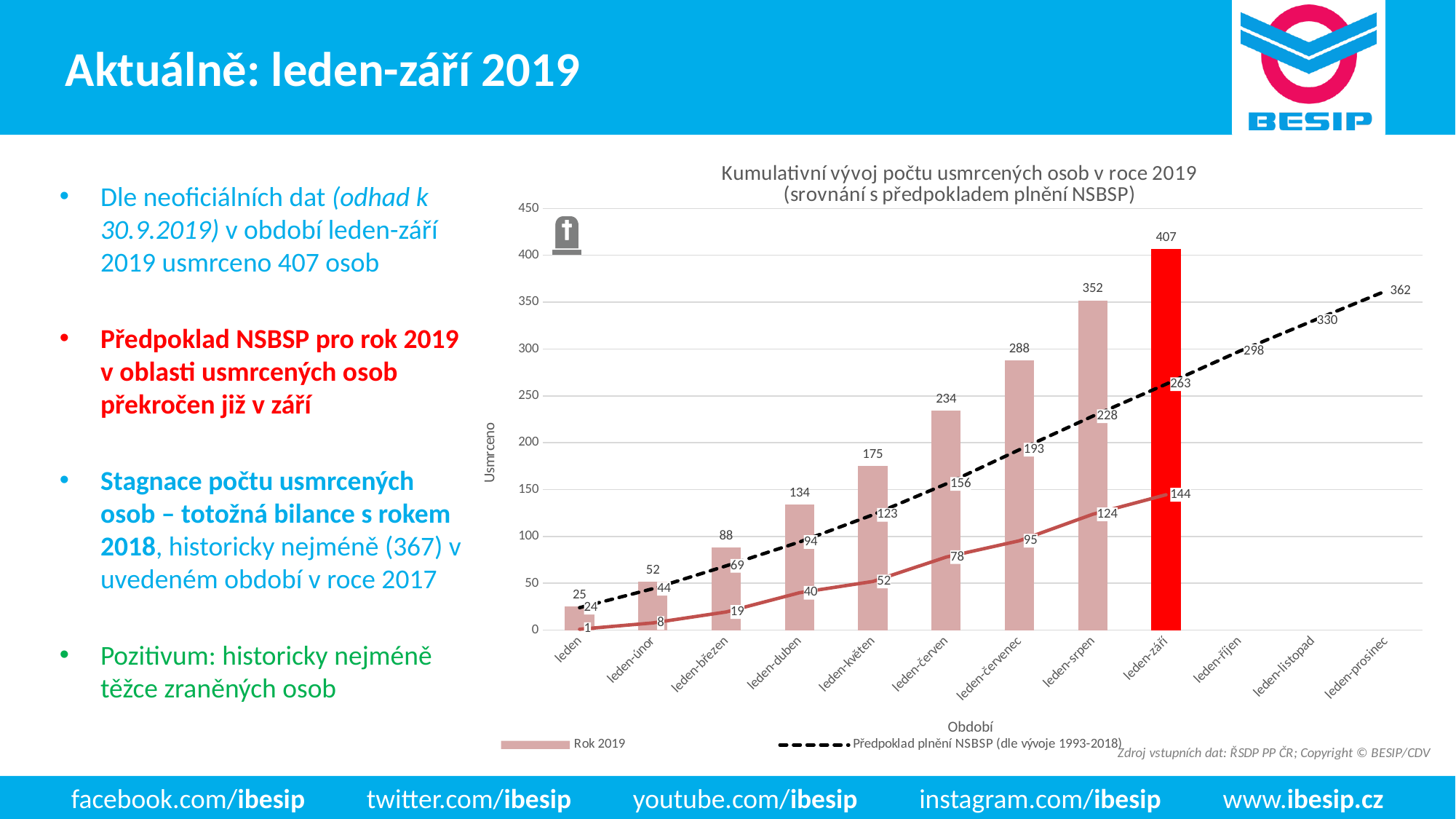
What is the title of the chart? Kumulativní vývoj počtu usmrcených osob v roce 2019 (srovnání s předpokladem plnění NSBSP) What is the difference between the Rok 2019 bar for leden-září (407) and the Předpoklad plnění NSBSP value for leden-září (263)? 144 Do the Rok 2019 bar values rise or fall from leden to leden-září? rise How many Rok 2019 bars are plotted on the chart? 9 Which period has the highest Rok 2019 bar? leden-září What is the value of the Předpoklad plnění NSBSP dashed line for leden-prosinec? 362 What is the value of the Předpoklad plnění NSBSP dashed line for leden-září? 263 Which period has the lowest Rok 2019 bar? leden What is the value of the Rok 2019 bar for leden-září? 407 What is the value of the Rok 2019 bar for leden-červen? 234 Which is larger for leden-srpen: the Rok 2019 bar or the Předpoklad plnění NSBSP dashed line value? Rok 2019 bar How many series does the legend list? 2